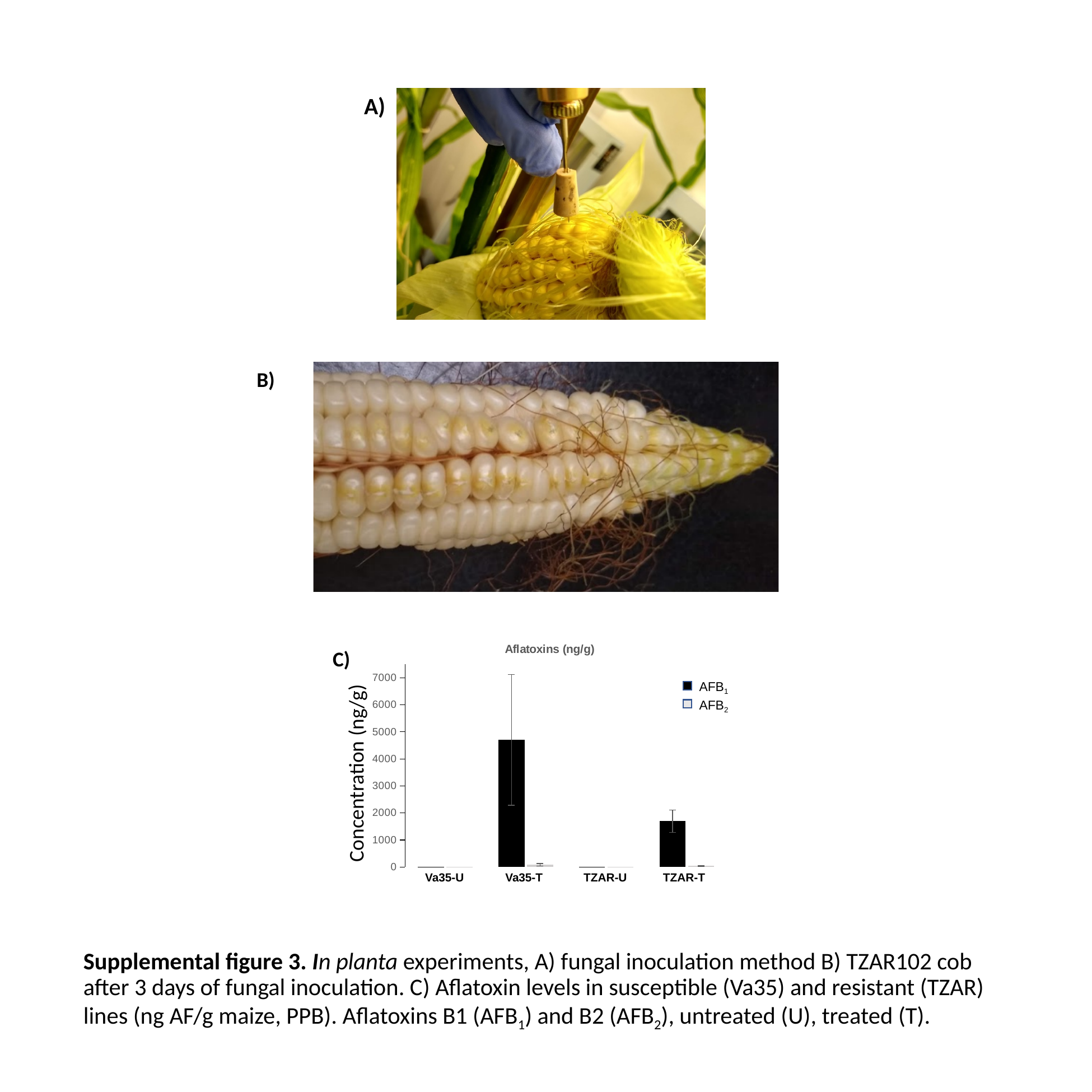
In the chart in panel C, is the AFB1 value for Va35-U greater or less than 1000? less In the chart in panel C, is the AFB1 value for Va35-T greater or less than 3000? greater What is the y-axis label of the chart in panel C? Concentration (ng/g) In the chart in panel C, is the AFB1 value for TZAR-T greater or less than 1000? greater In the chart in panel C, which is larger, the AFB1 value for Va35-T or the AFB1 value for TZAR-T? Va35-T What kind of chart is shown in panel C? bar chart In the chart in panel C, which category has the highest AFB1 concentration? Va35-T How many series does the legend of the chart in panel C list? 2 How many categories are shown on the x axis of the chart in panel C? 4 What is the title of the chart in panel C? Aflatoxins (ng/g) In the chart in panel C, which is larger for Va35-T, the AFB1 value or the AFB2 value? AFB1